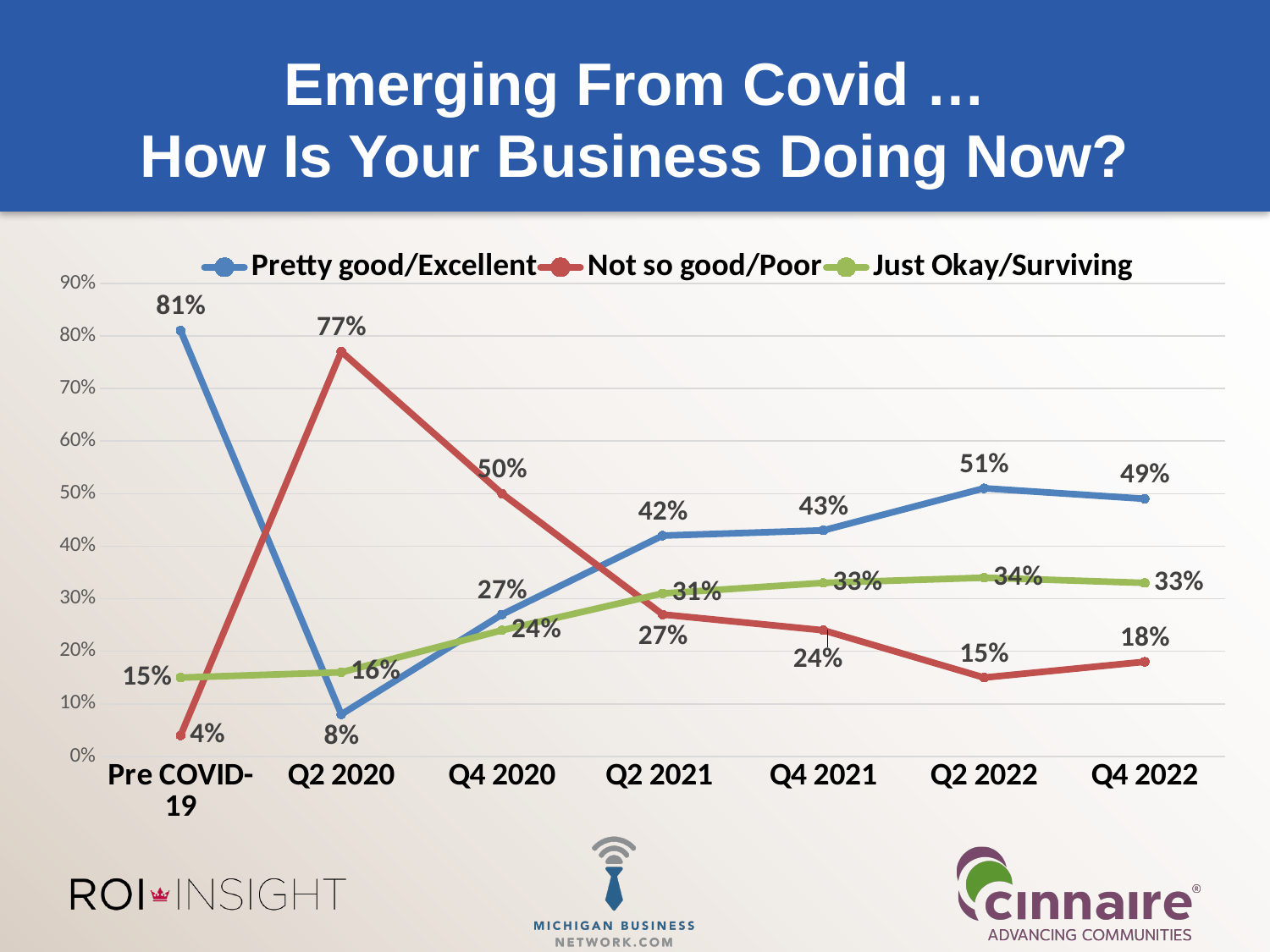
Does the Just Okay/Surviving series generally rise or fall from Pre COVID-19 to Q2 2022? rise What is the value for Just Okay/Surviving in Q4 2022? 33% What is the value for Not so good/Poor in Q2 2020? 77% What is the value for Pretty good/Excellent at Pre COVID-19? 81% How many time periods are shown on the x axis? 7 In which period is the Pretty good/Excellent series at its lowest? Q2 2020 In which period is the Not so good/Poor series at its highest? Q2 2020 How many series does the legend list? 3 Which series is shown in green? Just Okay/Surviving What type of chart is shown on the slide? line chart What is the difference between Pretty good/Excellent and Not so good/Poor in Q4 2022? 31% Which is larger in Q4 2020: Not so good/Poor or Pretty good/Excellent? Not so good/Poor